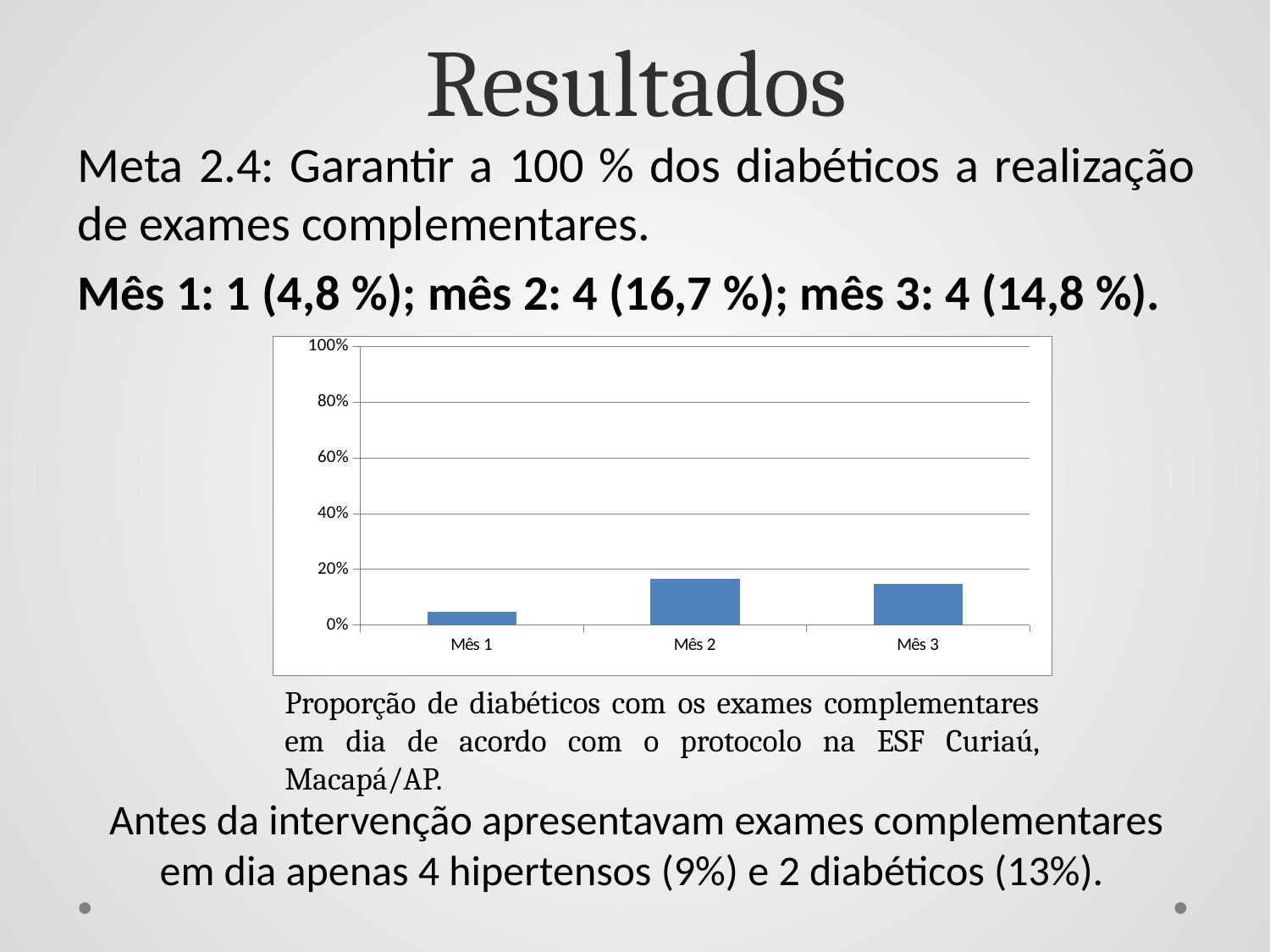
How many categories (months) are plotted on the x axis of the chart? 3 According to the slide, what proportion of diabetics had complementary exams up to date in Mês 2? 16,7 % Is the value for Mês 2 greater or less than 20%? less Do the bars rise or fall from Mês 1 to Mês 2? rise Which month has the lowest bar in the chart? Mês 1 What kind of chart is shown on the slide? bar chart Which month has the highest bar in the chart? Mês 2 According to the slide, what proportion of diabetics had complementary exams up to date in Mês 1? 4,8 % Which is larger, the bar for Mês 1 or the bar for Mês 3? Mês 3 What is the highest value shown on the chart's vertical axis? 100% According to the slide, what proportion of diabetics had complementary exams up to date in Mês 3? 14,8 % Is the value for Mês 1 greater or less than 20%? less